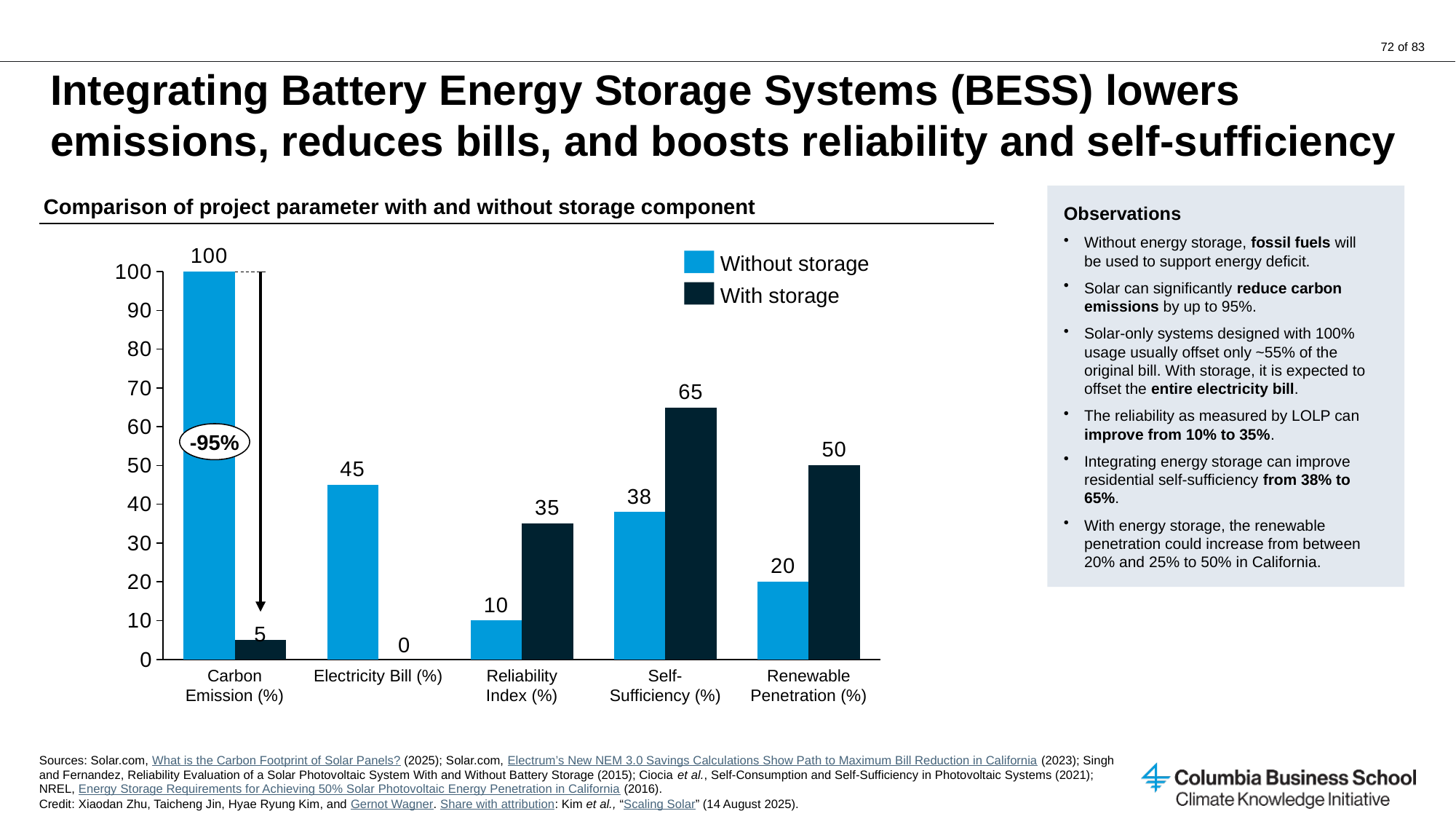
Which is larger for Reliability Index (%): the value with storage or without storage? With storage How many categories are shown on the x axis? 5 Which category has the highest value in the With storage series? Self-Sufficiency (%) What is the difference between the with-storage and without-storage values for Renewable Penetration (%)? 30 What percentage change is shown in the oval annotation next to the Carbon Emission bars? -95% What is the value for Electricity Bill (%) with storage? 0 What kind of chart is shown on the slide? Bar chart Which category has the lowest value in the Without storage series? Reliability Index (%) What is the value for Self-Sufficiency (%) with storage? 65 What is the value for Reliability Index (%) without storage? 10 What is the value for Carbon Emission (%) without storage? 100 How many series does the legend list? 2